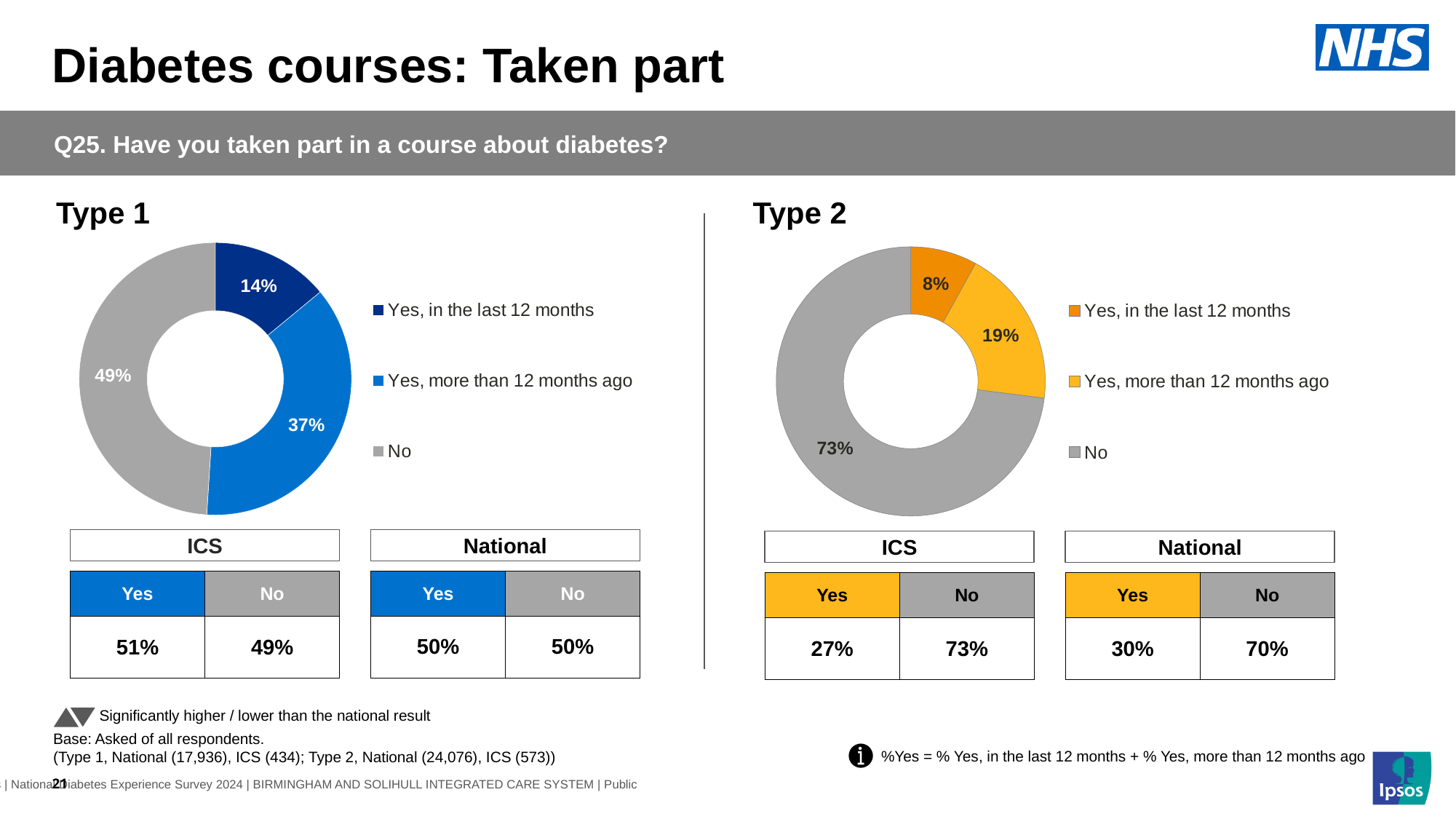
In the Type 1 chart, what percentage of respondents answered 'Yes, in the last 12 months'? 14% In the Type 1 chart, what colour is the 'No' segment? Grey How many categories does the Type 2 chart show? 3 How many entries does the legend of the Type 2 chart list? 3 In the Type 2 chart, what percentage of respondents answered 'Yes, more than 12 months ago'? 19% In the Type 1 chart, which is larger: 'Yes, more than 12 months ago' or 'Yes, in the last 12 months'? Yes, more than 12 months ago What kind of chart is used for Type 1? Doughnut chart In the Type 2 chart, what is the difference between the 'No' share and the 'Yes, more than 12 months ago' share? 54 percentage points In the Type 1 chart, what is the combined share of the two 'Yes' responses? 51% In the Type 1 chart, which response has the largest share? No In the Type 2 chart, which response has the smallest share? Yes, in the last 12 months In the Type 2 chart, what share of the doughnut is 'No'? 73%